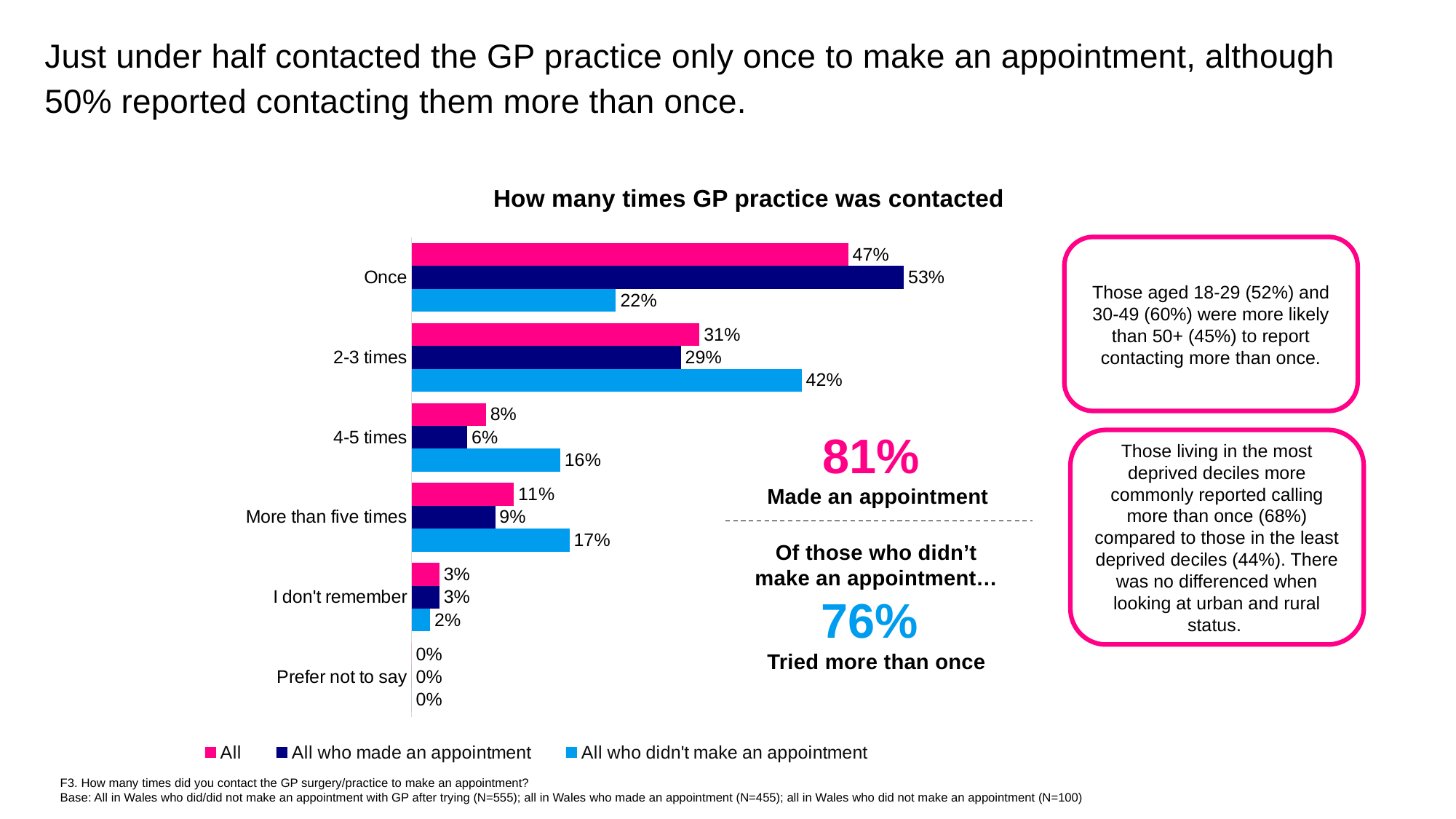
For 'More than five times', which series has the larger value: 'All' or 'All who didn't make an appointment'? All who didn't make an appointment What kind of chart is shown? Bar chart How many categories are shown on the chart? 6 What is the value for '2-3 times' in the 'All who didn't make an appointment' series? 42% How many series does the legend list? 3 Which category has the highest value in the 'All who made an appointment' series? Once What is the value for 'I don't remember' in the 'All who didn't make an appointment' series? 2% What is the difference between the 'All who made an appointment' and 'All who didn't make an appointment' values for 'Once'? 31% Which category has the highest value in the 'All who didn't make an appointment' series? 2-3 times What is the value for '4-5 times' in the 'All who made an appointment' series? 6% What is the title of the chart? How many times GP practice was contacted What is the value for 'Once' in the 'All' series? 47%